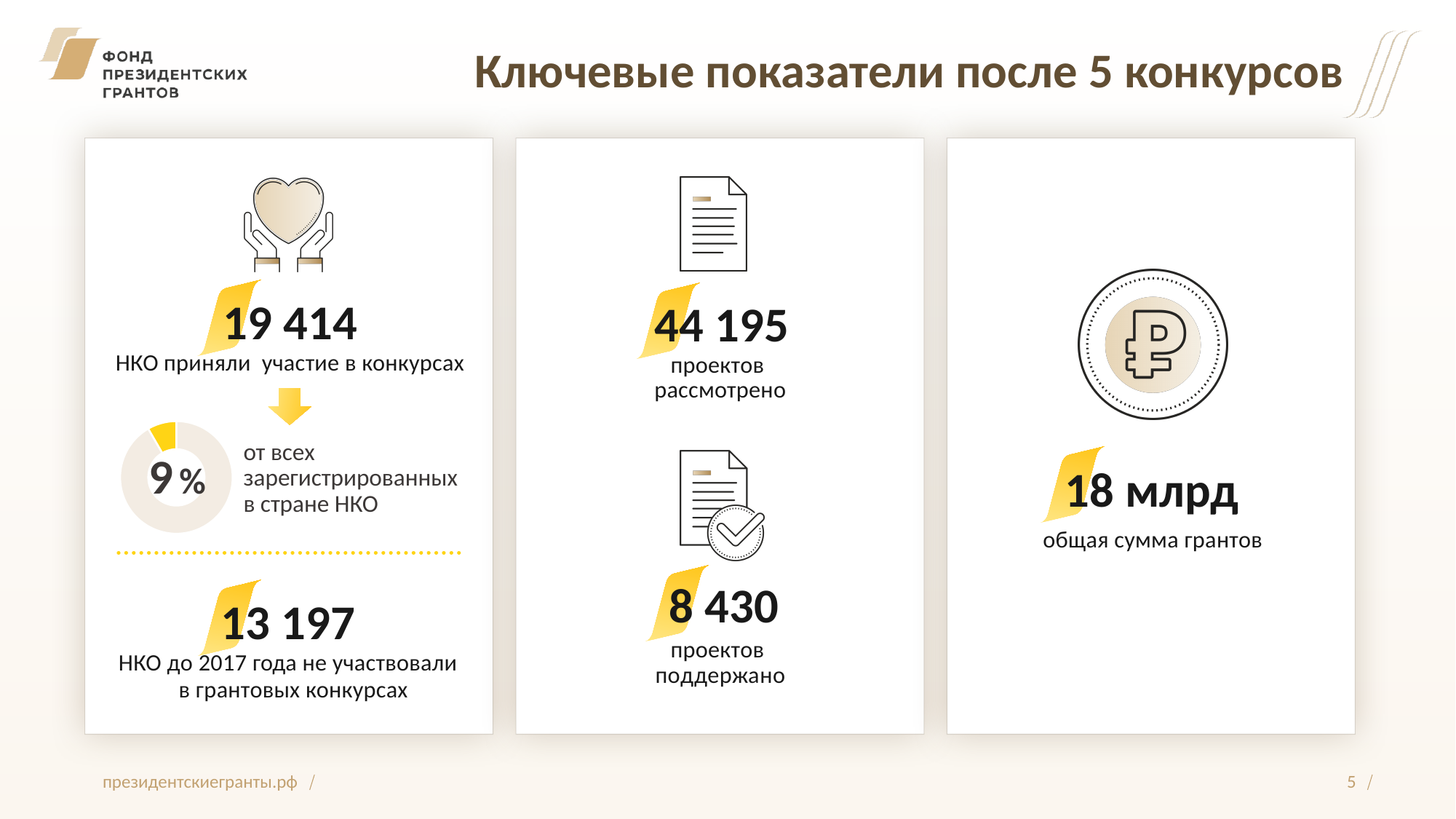
According to the text beside the donut chart, what does the 9 % refer to? от всех зарегистрированных в стране НКО What share of all registered NGOs in the country does the highlighted slice of the donut chart represent? 9 % What kind of chart is shown in the left panel next to the text "от всех зарегистрированных в стране НКО"? pie chart (donut) What value is printed in the centre of the donut chart on the left panel? 9 % What colour is the highlighted slice of the donut chart? yellow In the donut chart, which is larger: the highlighted yellow slice or the remaining grey portion? the remaining grey portion How many segments does the donut chart on the left panel have? 2